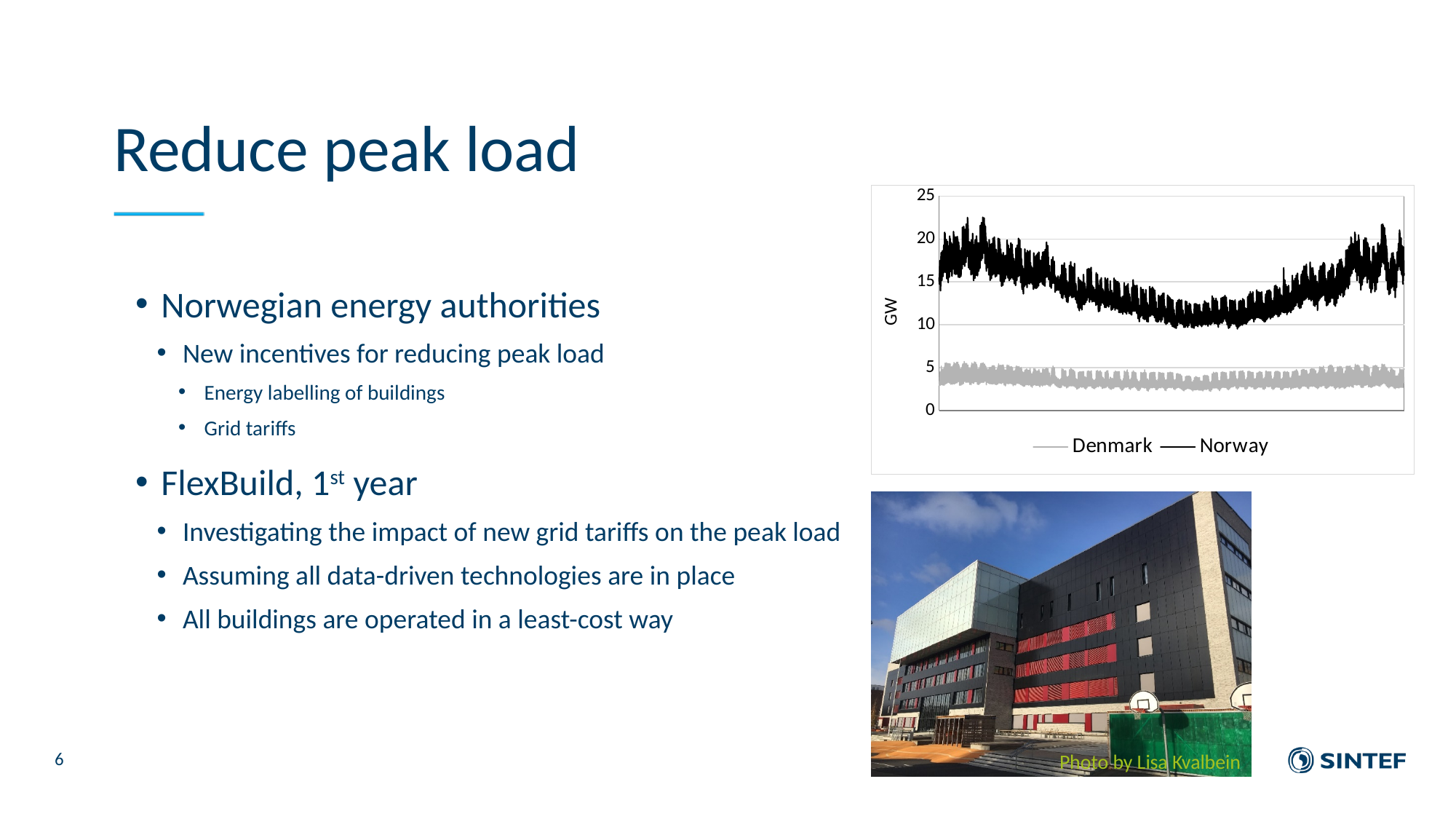
Which series has the higher values throughout the chart, Denmark or Norway? Norway Is the lowest value for Norway greater or less than 15 GW? less What is the maximum value shown on the chart's vertical axis? 25 What is the label on the chart's vertical axis? GW Is the highest value for Norway greater or less than 20 GW? greater What kind of chart is shown on the slide? line chart How many series does the chart's legend list? 2 Is the value for Norway greater or less than 5 GW across the whole chart? greater Which two series are listed in the chart's legend? Denmark and Norway Which series has the lower values throughout the chart? Denmark Does the Norway series fall or rise from the left edge of the chart to its middle? fall